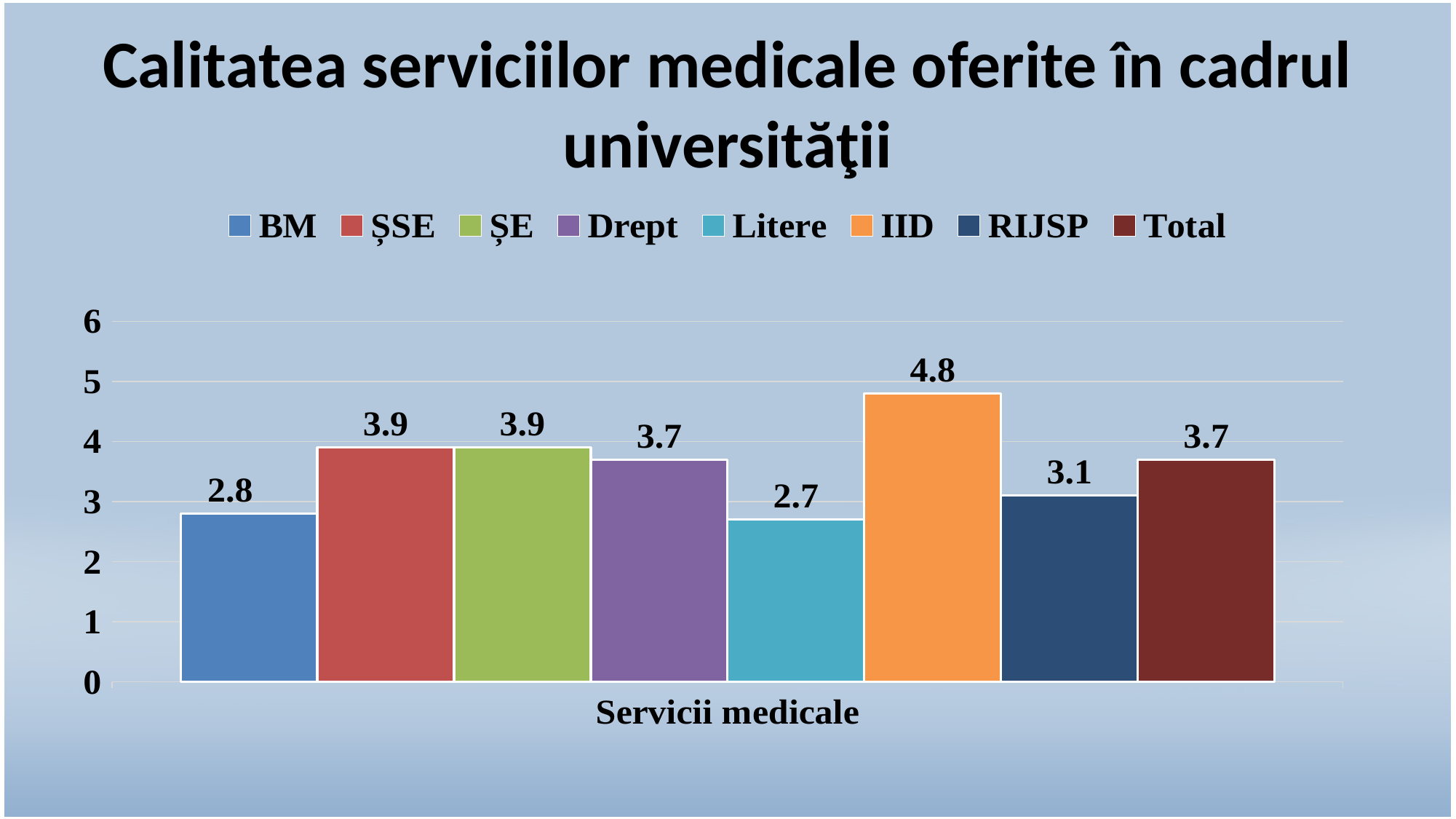
What is the value for IID? 4.8 Which series has the lowest value? Litere Which series has the highest value? IID Which is larger, the value for Drept or the value for RIJSP? Drept What is the value for BM? 2.8 How many series does the legend list? 8 What is the difference between the values for IID and Litere? 2.1 What is the label on the x axis of the chart? Servicii medicale What kind of chart is shown on the slide? bar chart What is the value for RIJSP? 3.1 Is the value for ȘSE greater or less than 3? greater What is the value for Total? 3.7